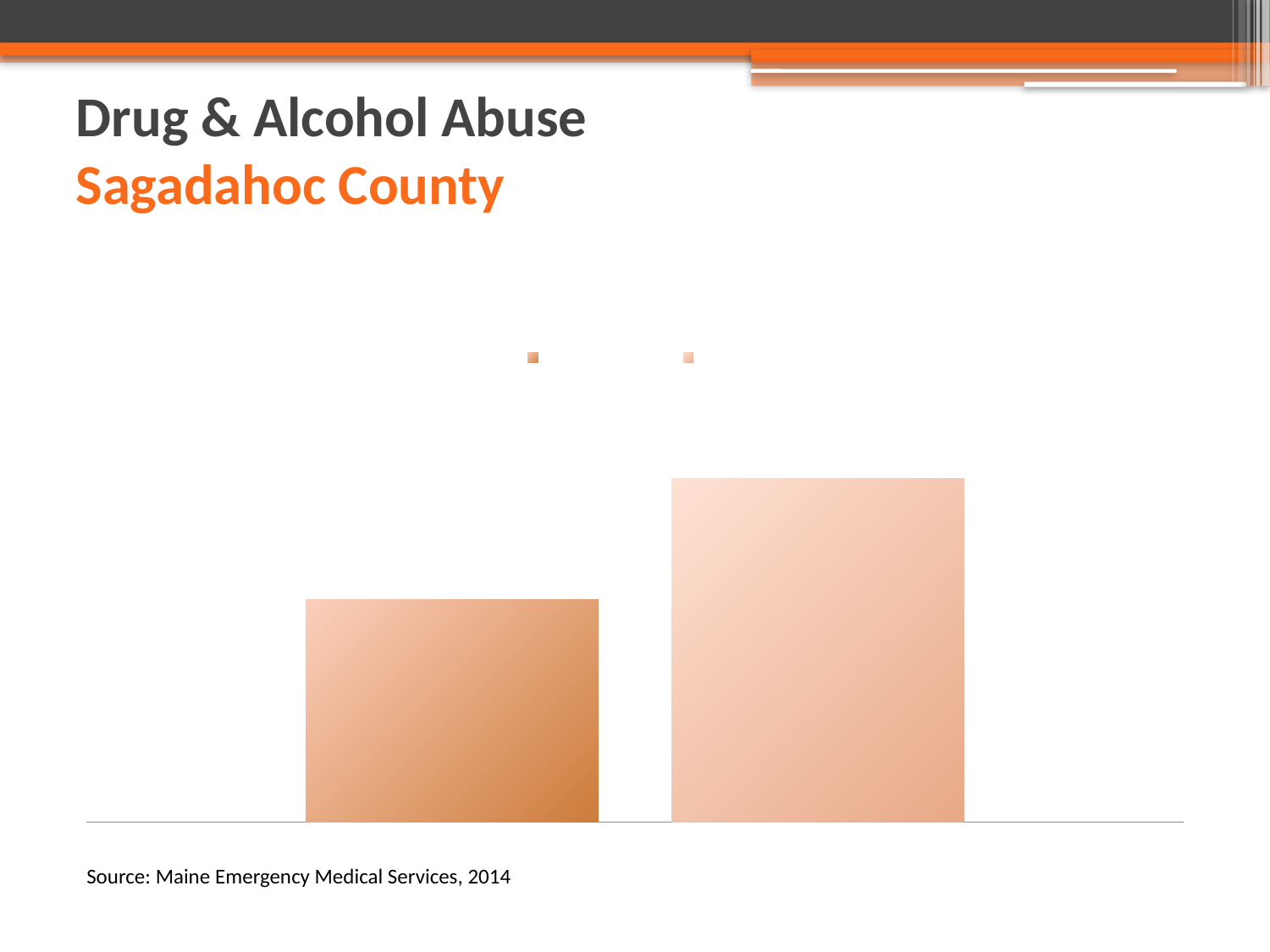
Do the bars rise or fall from left to right? rise What kind of chart is shown on the slide? bar chart Which bar is the shortest in the chart, the left or the right? the left bar Which county is named in the slide title above the chart? Sagadahoc County How many entries does the chart's legend show? 2 Which bar is taller, the left bar or the right bar? the right bar How many bars are plotted in the chart? 2 What source is cited below the chart? Maine Emergency Medical Services, 2014